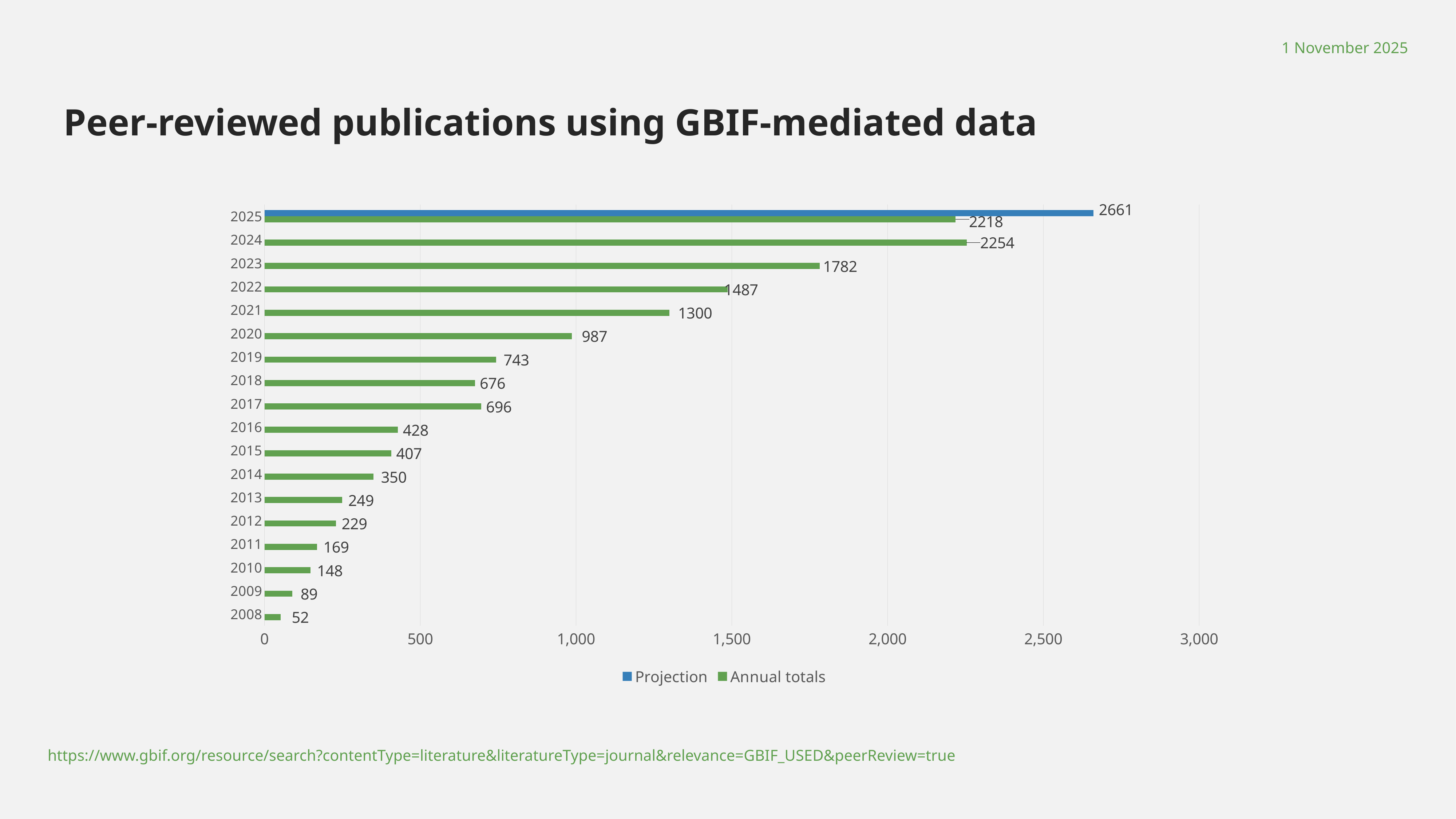
Which year has the lowest Annual totals value? 2008 What is the Annual totals value for 2008? 52 How many years are shown on the chart? 18 What is the Projection value for 2025? 2661 What kind of chart is shown on the slide? bar chart How many series does the legend list? 2 Is the Annual totals value for 2020 greater or less than 1,000? less What is the title of the chart? Peer-reviewed publications using GBIF-mediated data Which is larger, the Annual totals value for 2017 or for 2018? 2017 What is the difference between the Annual totals for 2024 and 2023? 472 Which year has the highest Annual totals value? 2024 What is the Annual totals value for 2023? 1782